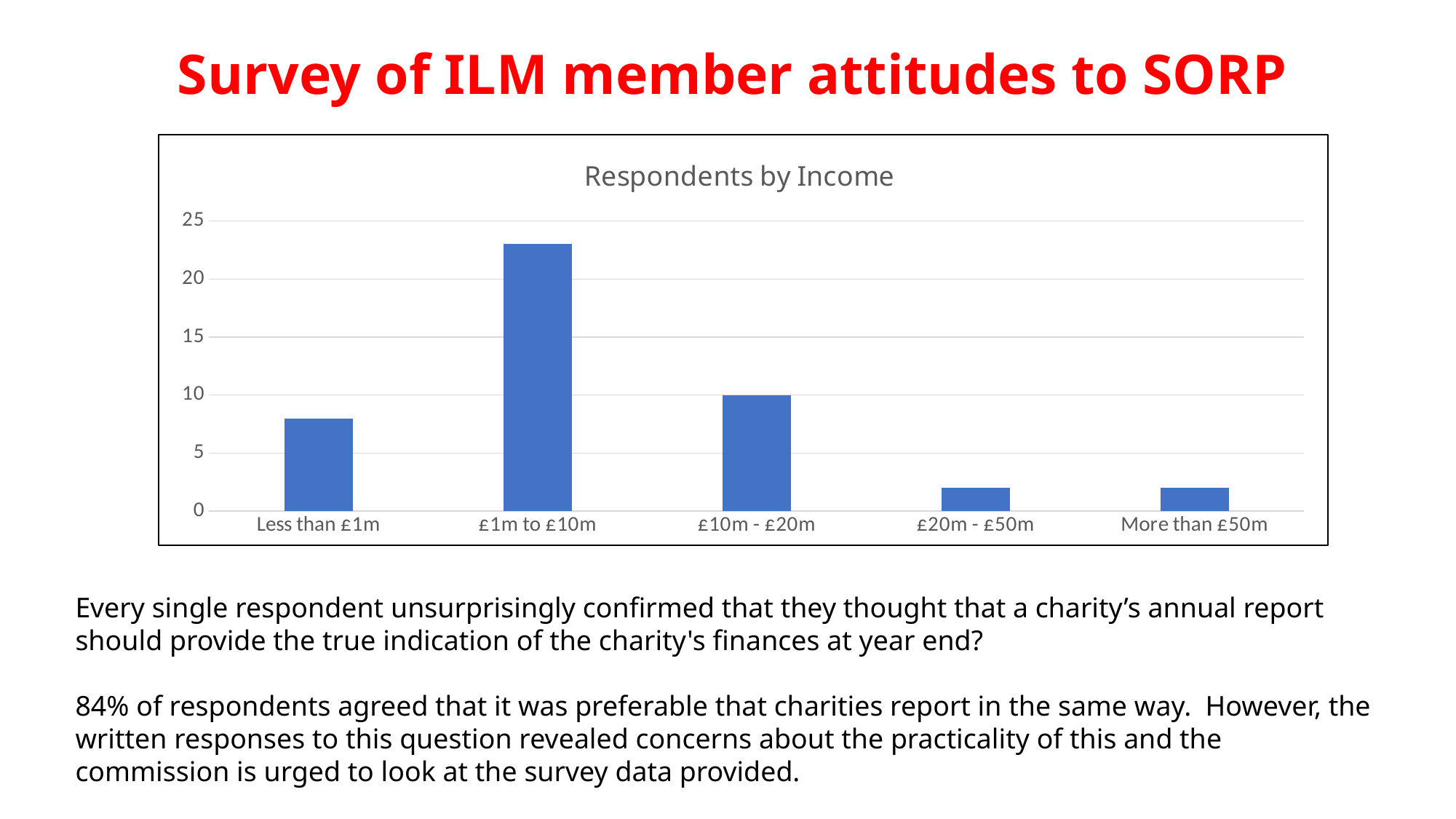
Which has more respondents, £1m to £10m or £10m - £20m? £1m to £10m Is the value for More than £50m greater or less than 5? less What type of chart is shown on the slide? bar chart Which has more respondents, Less than £1m or £10m - £20m? £10m - £20m How many respondents are in the £10m - £20m category? 10 What is the title of the chart? Respondents by Income Is the value for £1m to £10m greater or less than 20? greater Is the value for Less than £1m greater or less than 10? less How many income categories are shown on the x axis? 5 Which income category has the highest number of respondents? £1m to £10m